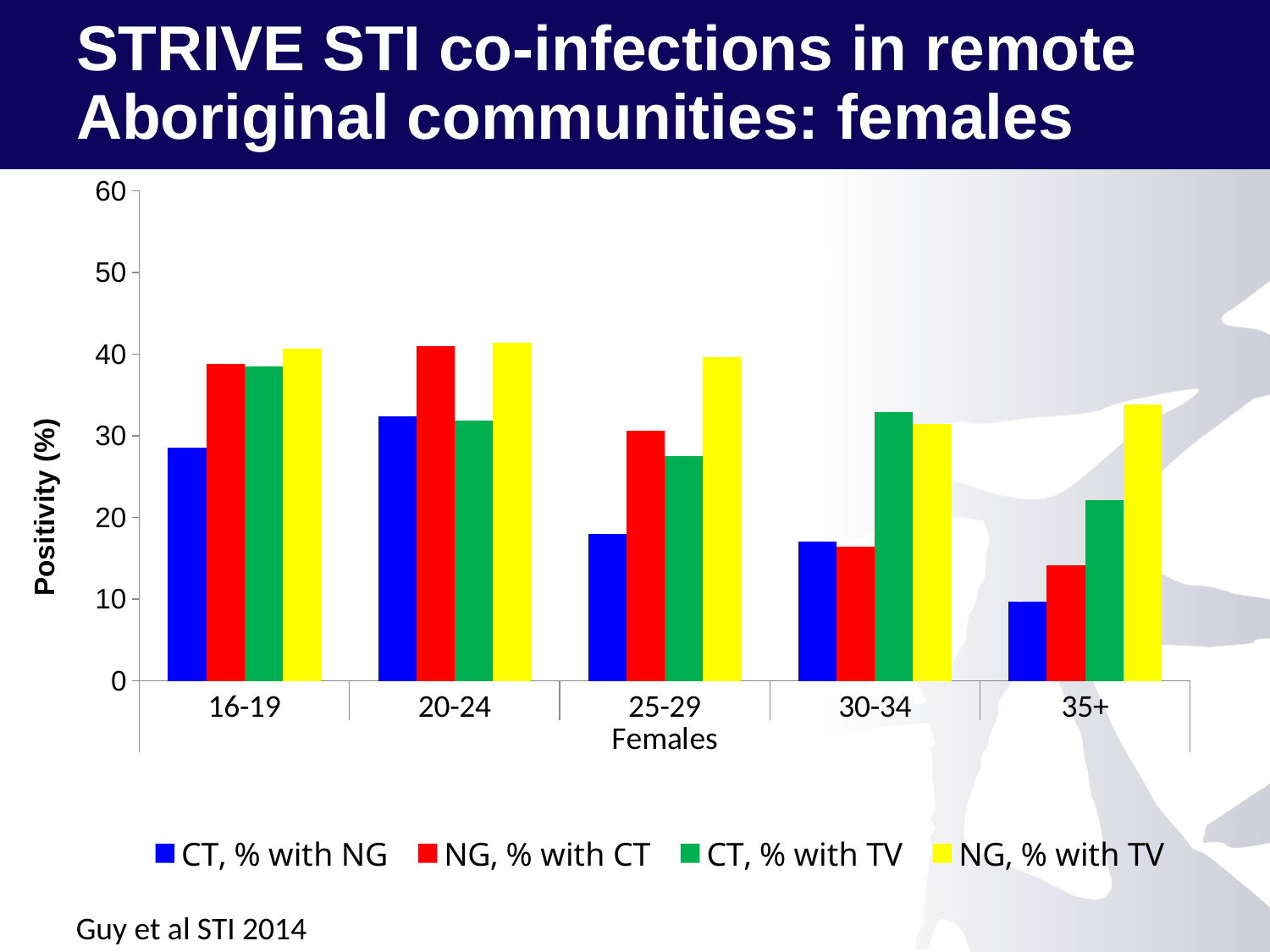
How many age groups are shown on the x axis? 5 What is the label on the y axis? Positivity (%) Is the value for CT, % with TV in the 35+ age group greater or less than 30? less From the 20-24 age group to the 35+ age group, does the value for NG, % with CT rise or fall? fall Which age group has the lowest value for CT, % with NG? 35+ How many series does the legend list? 4 In the 35+ age group, which is larger: NG, % with TV or CT, % with TV? NG, % with TV Which age group has the highest value for CT, % with NG? 20-24 Is the value for NG, % with TV in the 20-24 age group greater or less than 30? greater In the 25-29 age group, which series has the highest value? NG, % with TV What kind of chart is shown on the slide? bar chart Is the value for CT, % with NG in the 25-29 age group greater or less than 20? less